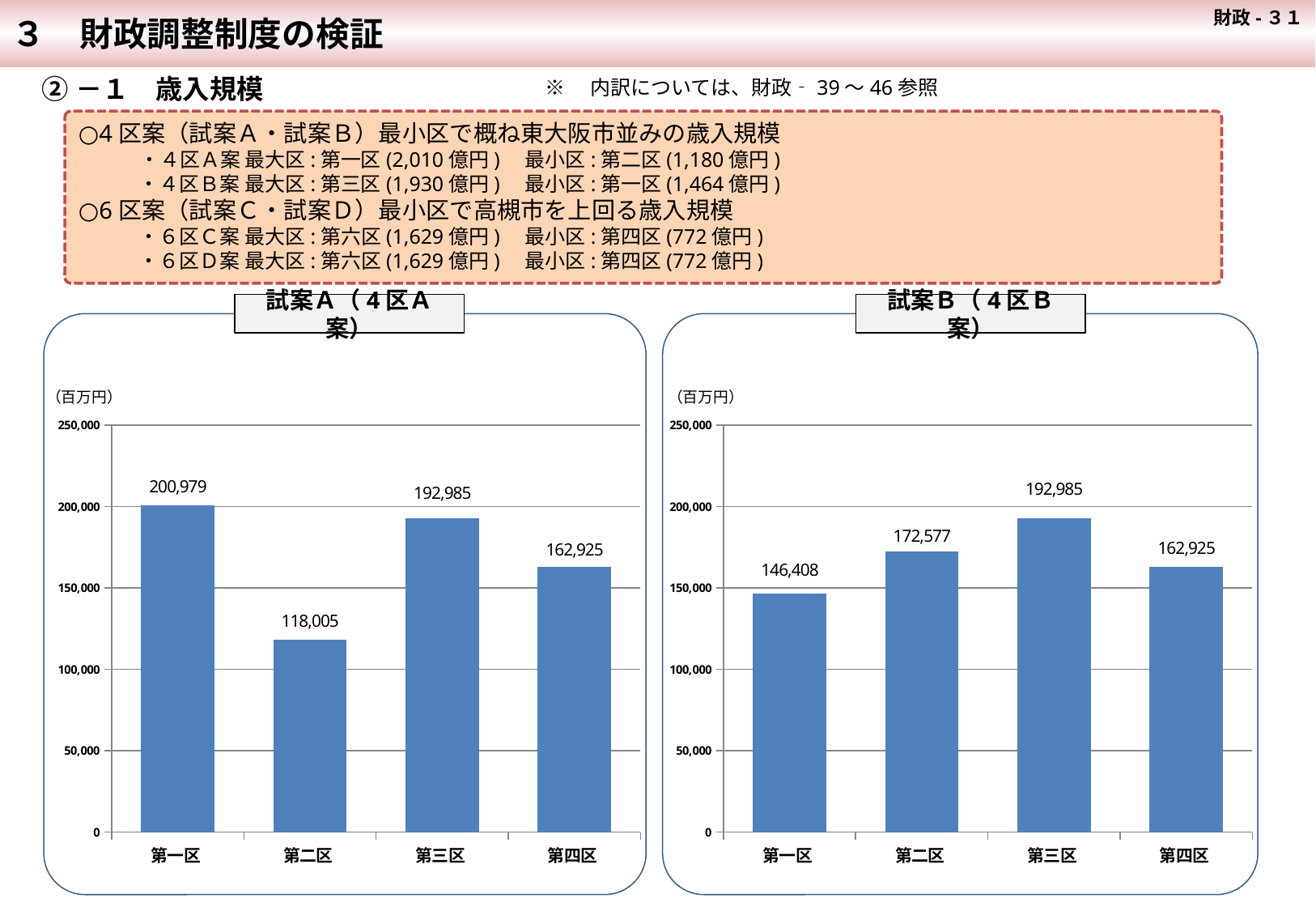
In the 試案A（4区A案） chart, what is the difference between the values for 第一区 and 第二区? 82,974 In the 試案A（4区A案） chart, is the value for 第二区 greater or less than 150,000? less In the 試案B（4区B案） chart, what is the value for 第二区? 172,577 In the 試案B（4区B案） chart, which district has the highest value? 第三区 How many districts are shown on the x axis of the 試案A（4区A案） chart? 4 In the 試案A（4区A案） chart, what is the value for 第一区? 200,979 In the 試案B（4区B案） chart, which is larger, the value for 第二区 or the value for 第四区? 第二区 In the 試案B（4区B案） chart, what is the difference between the values for 第三区 and 第一区? 46,577 What type of chart is the 試案B（4区B案） chart? bar chart In the 試案A（4区A案） chart, which district has the lowest value? 第二区 In the 試案B（4区B案） chart, what is the value for 第四区? 162,925 What unit is shown above the y axis of the 試案A（4区A案） chart? 百万円